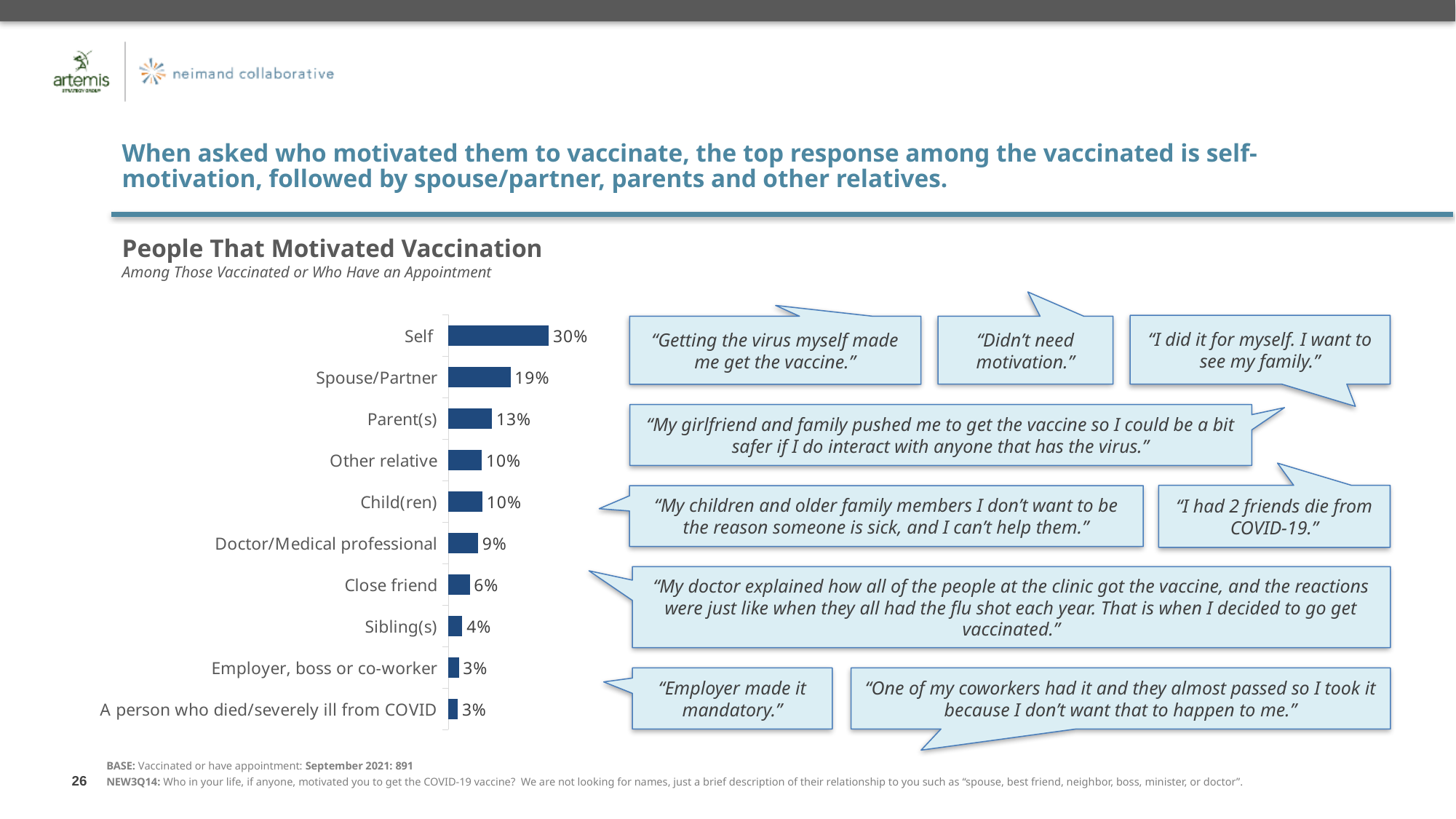
What is the title of the chart? People That Motivated Vaccination What is the difference between the values for Self and Spouse/Partner? 11 percentage points What percentage of respondents said Self motivated their vaccination? 30% Which category has the highest value in the chart? Self What percentage is shown for Doctor/Medical professional? 9% What is the base size stated for the chart? 891 What is the difference between the values for Other relative and Employer, boss or co-worker? 7 percentage points Which is larger, the value for Parent(s) or the value for Close friend? Parent(s) What is the value for Spouse/Partner? 19% What is the value for Sibling(s)? 4% How many categories are shown in the chart? 10 What kind of chart is shown on the slide? Bar chart